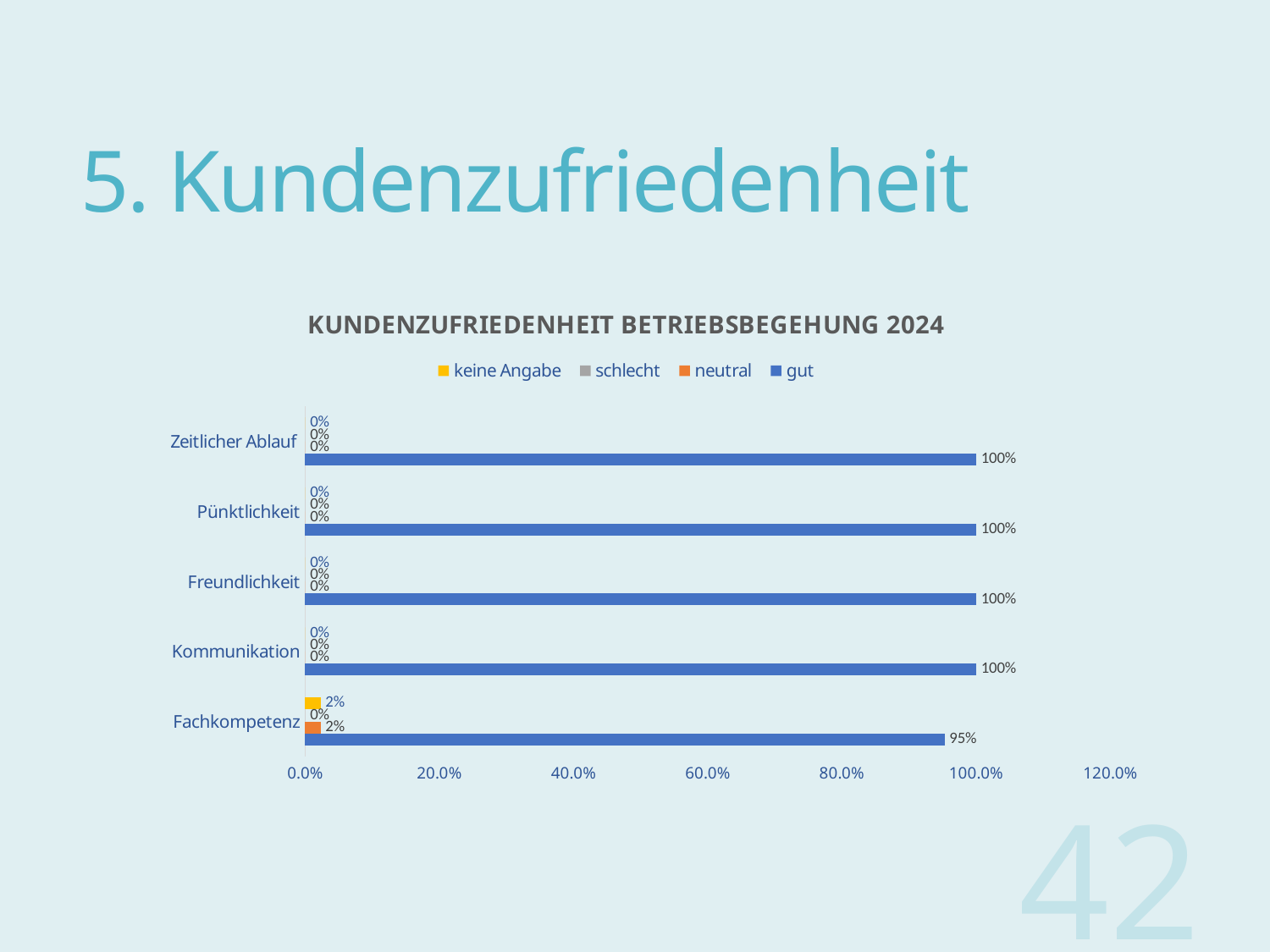
How many categories are shown on the chart? 5 What is the value of "neutral" for Fachkompetenz? 2% How many series does the legend list? 4 What is the difference between the "gut" value for Zeitlicher Ablauf and the "gut" value for Fachkompetenz? 5% What is the value of "gut" for Pünktlichkeit? 100% What is the title of the chart? KUNDENZUFRIEDENHEIT BETRIEBSBEGEHUNG 2024 What is the value of "keine Angabe" for Fachkompetenz? 2% What kind of chart is shown on the slide? Bar chart Which category has the lowest value for "gut"? Fachkompetenz Which is larger: the "gut" value for Freundlichkeit or the "gut" value for Fachkompetenz? Freundlichkeit What is the value of "gut" for Fachkompetenz? 95% What is the value of "schlecht" for Kommunikation? 0%